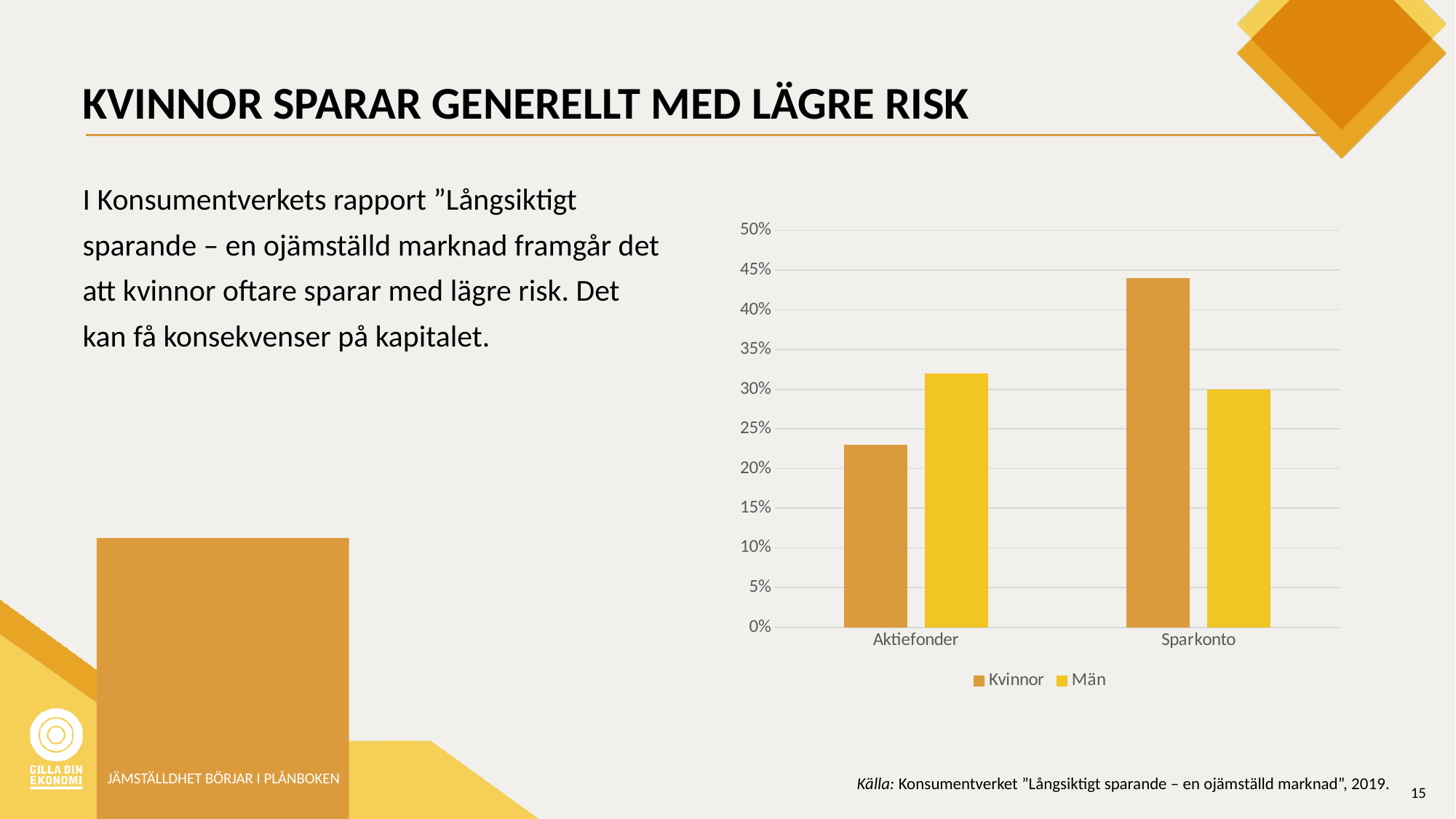
Is the value for Män in Aktiefonder greater or less than 30%? greater What kind of chart is shown on the slide? Bar chart Which series has the lowest bar in the chart, and for which category? Kvinnor, Aktiefonder Is the value for Kvinnor in Sparkonto greater or less than 40%? greater How many categories are shown on the x axis of the chart? 2 For Sparkonto, which series has the larger value, Kvinnor or Män? Kvinnor For Aktiefonder, which series has the larger value, Kvinnor or Män? Män Is the value for Kvinnor in Aktiefonder greater or less than 25%? less How many series does the chart's legend list? 2 What are the two series named in the chart's legend? Kvinnor and Män Which category has the highest bar in the chart? Sparkonto